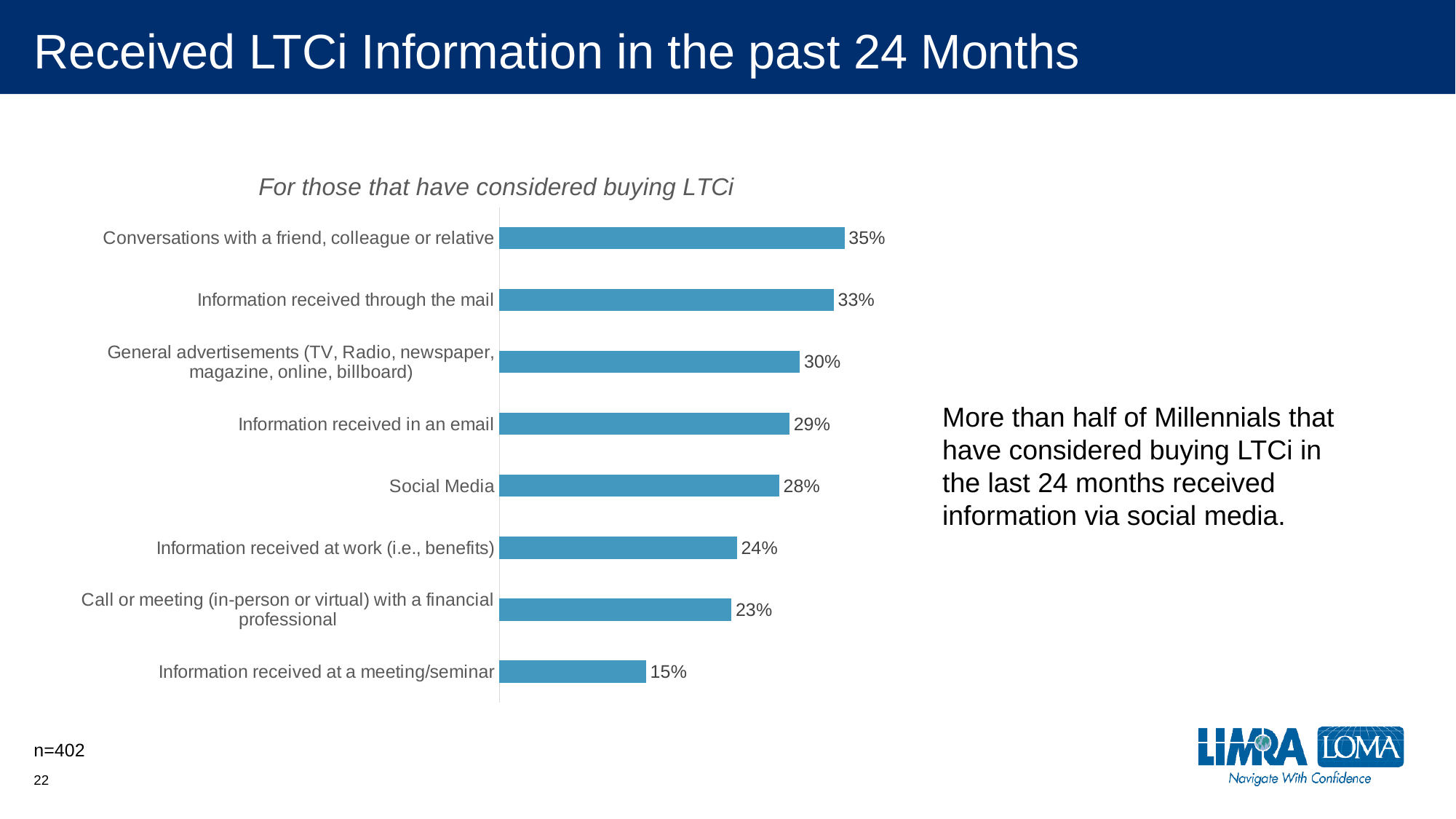
Which source has the lowest percentage? Information received at a meeting/seminar What percentage received LTCi information through conversations with a friend, colleague or relative? 35% What is the difference between information received through the mail and information received in an email? 4% What is the sample size (n) noted on the slide? n=402 What is the value for Social Media? 28% What percentage received information at a meeting/seminar? 15% Which is larger: general advertisements or call or meeting with a financial professional? General advertisements Which source has the highest percentage? Conversations with a friend, colleague or relative What is the subtitle shown above the chart? For those that have considered buying LTCi What type of chart is shown on the slide? Bar chart How many information sources are shown in the chart? 8 What is the value for information received at work (i.e., benefits)? 24%